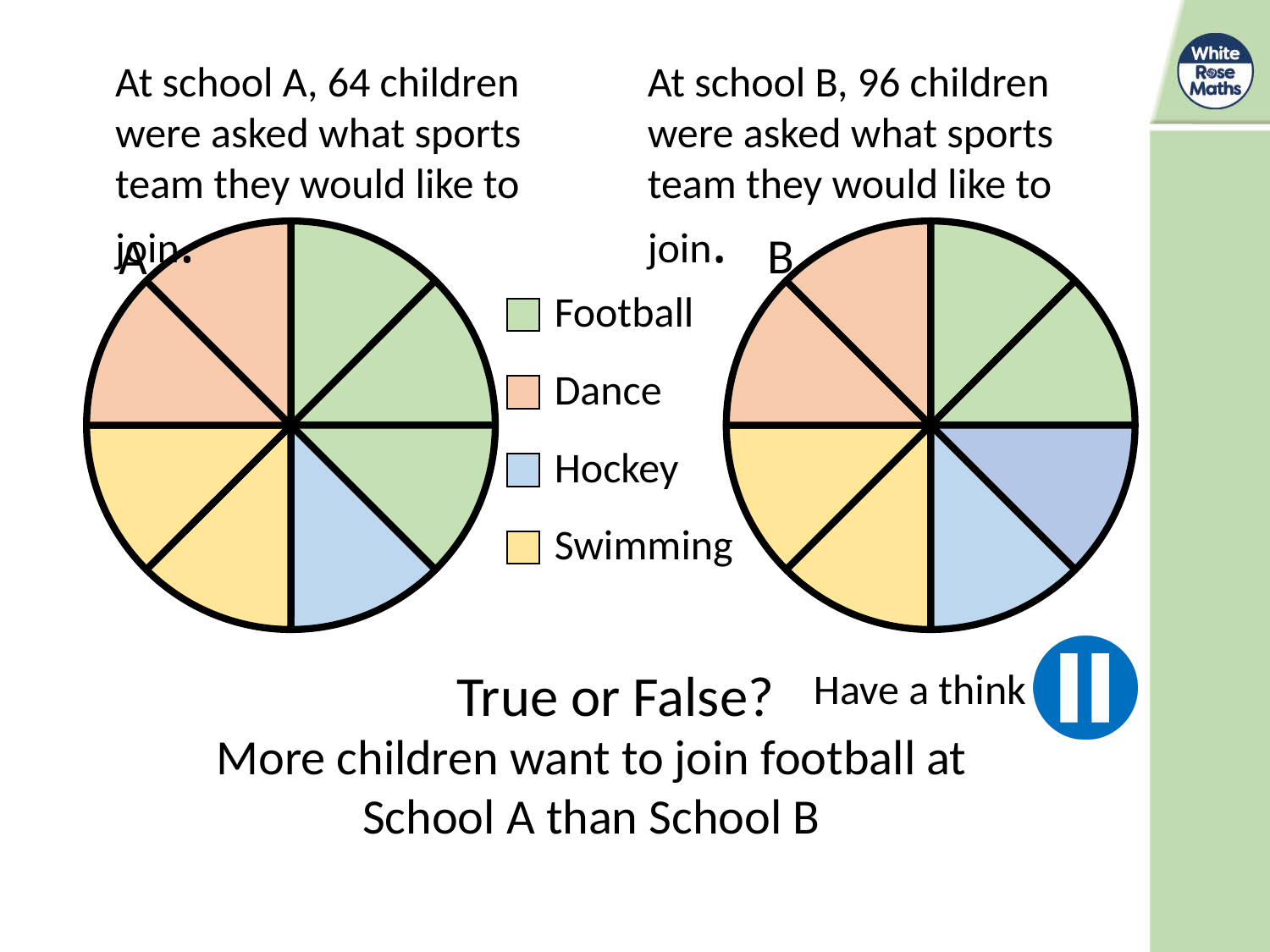
How many categories are shown in pie chart A? 4 In pie chart A, what fraction of the pie is Football? 3/8 How many entries does the legend list? 4 According to the slide, how many children were asked at school B? 96 Which pie chart has the larger share for Football, A or B? A In pie chart A, which slice is larger, Football or Hockey? Football What kind of charts are shown on the slide? Pie charts Which colour represents Swimming in the legend? Yellow In pie chart B, what fraction of the pie is Football? 1/4 In pie chart A, which sport has the largest slice? Football In pie chart A, which sport has the smallest slice? Hockey In pie chart A, which slice is larger, Dance or Hockey? Dance